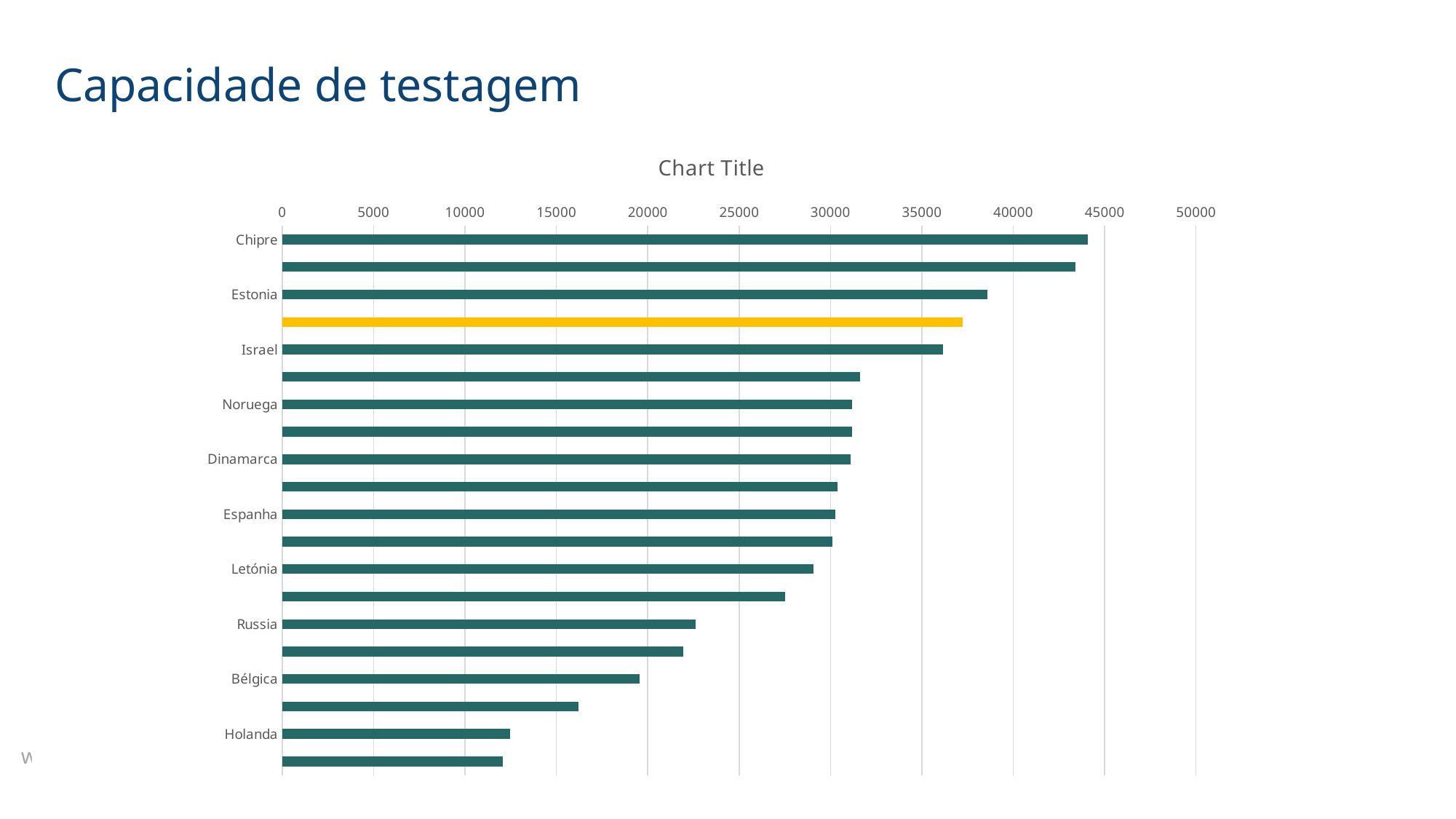
Is the value for Estonia greater or less than 35000? greater Is the value for Holanda greater or less than 15000? less How many bars are plotted in the chart? 20 Which has the larger value, Estonia or Israel? Estonia What is the title shown above the chart? Chart Title Is the value for Chipre greater or less than 40000? greater Which labelled category has the longest bar? Chipre Which has the larger value, Espanha or Russia? Espanha What kind of chart is shown on the slide? bar chart What colour is the single highlighted bar that differs from the others? yellow